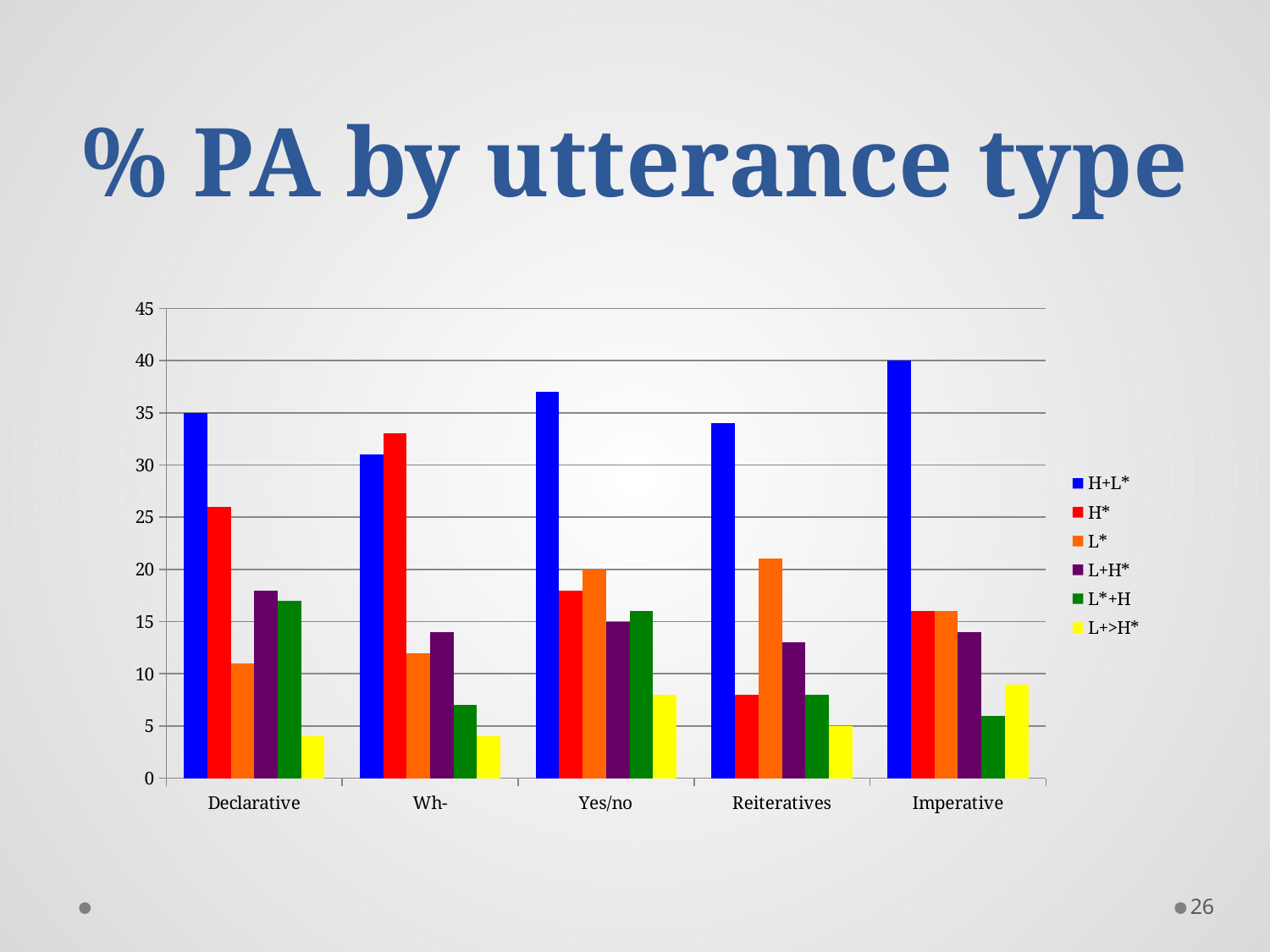
What is the H+L* value for Imperative? 40 What is the H+L* value for Declarative? 35 What is the title of the slide? % PA by utterance type What kind of chart is shown on the slide? bar chart Which utterance type has the highest H* value? Wh- How many utterance type categories are shown on the x axis? 5 Is the L* value for Declarative greater or less than 15? less Which utterance type has the highest H+L* value? Imperative Is the H+L* value for Yes/no greater or less than 35? greater For Yes/no, which is larger: L*+H or L+>H*? L*+H Is the H* value for Reiteratives greater or less than 10? less How many series does the legend list? 6